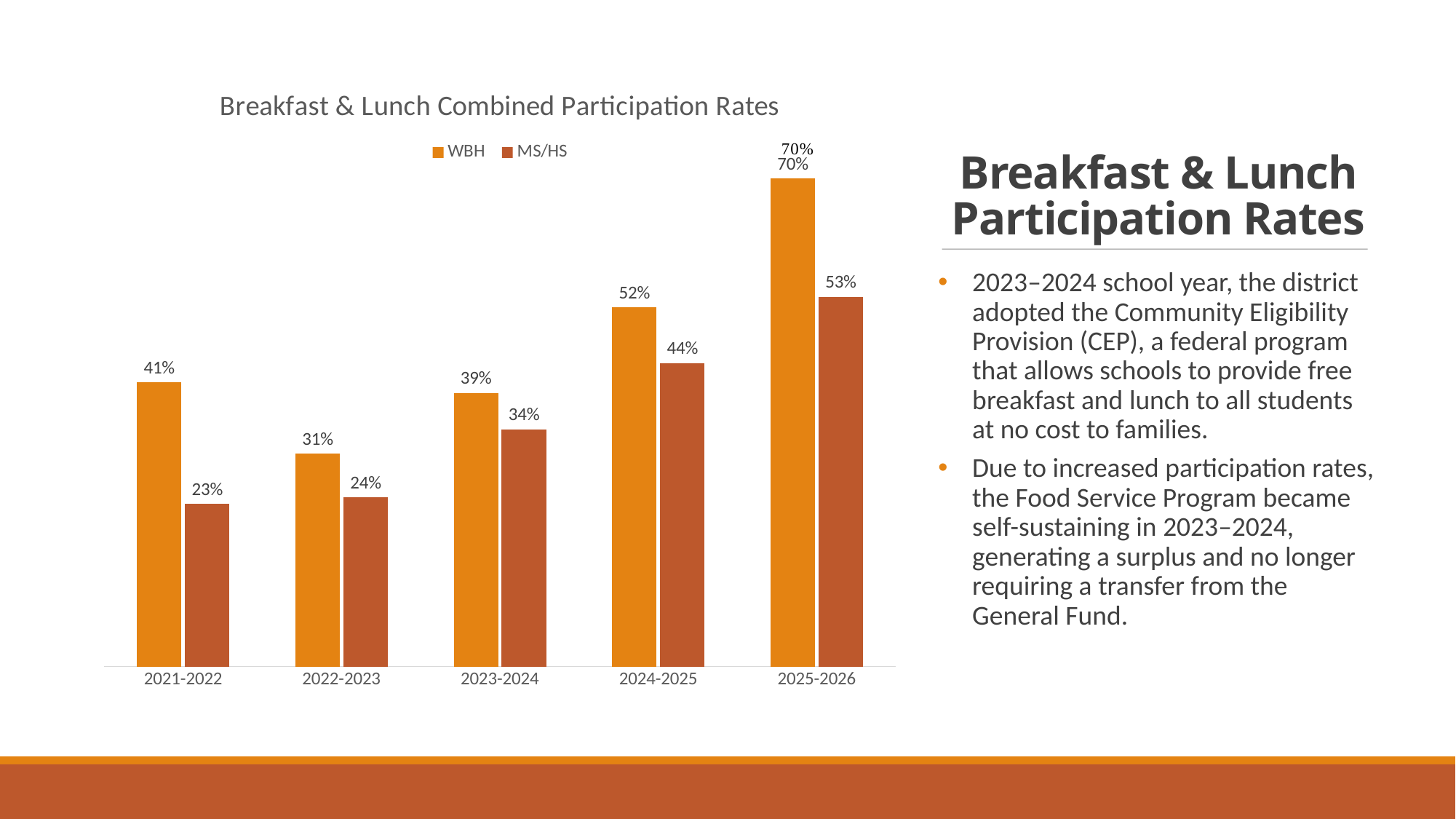
What is the MS/HS participation rate for 2025-2026? 53% What kind of chart is shown on the slide? Bar chart What is the difference between the WBH and MS/HS participation rates in 2024-2025? 8% How many school years are shown on the x axis? 5 What is the WBH participation rate for 2021-2022? 41% What is the title of the chart? Breakfast & Lunch Combined Participation Rates Which school year has the lowest MS/HS participation rate? 2021-2022 Does the MS/HS participation rate rise or fall from 2021-2022 to 2025-2026? Rise How many series does the legend list? 2 Which school year has the highest WBH participation rate? 2025-2026 What is the MS/HS participation rate for 2023-2024? 34% Which is larger in 2022-2023, the WBH rate or the MS/HS rate? WBH